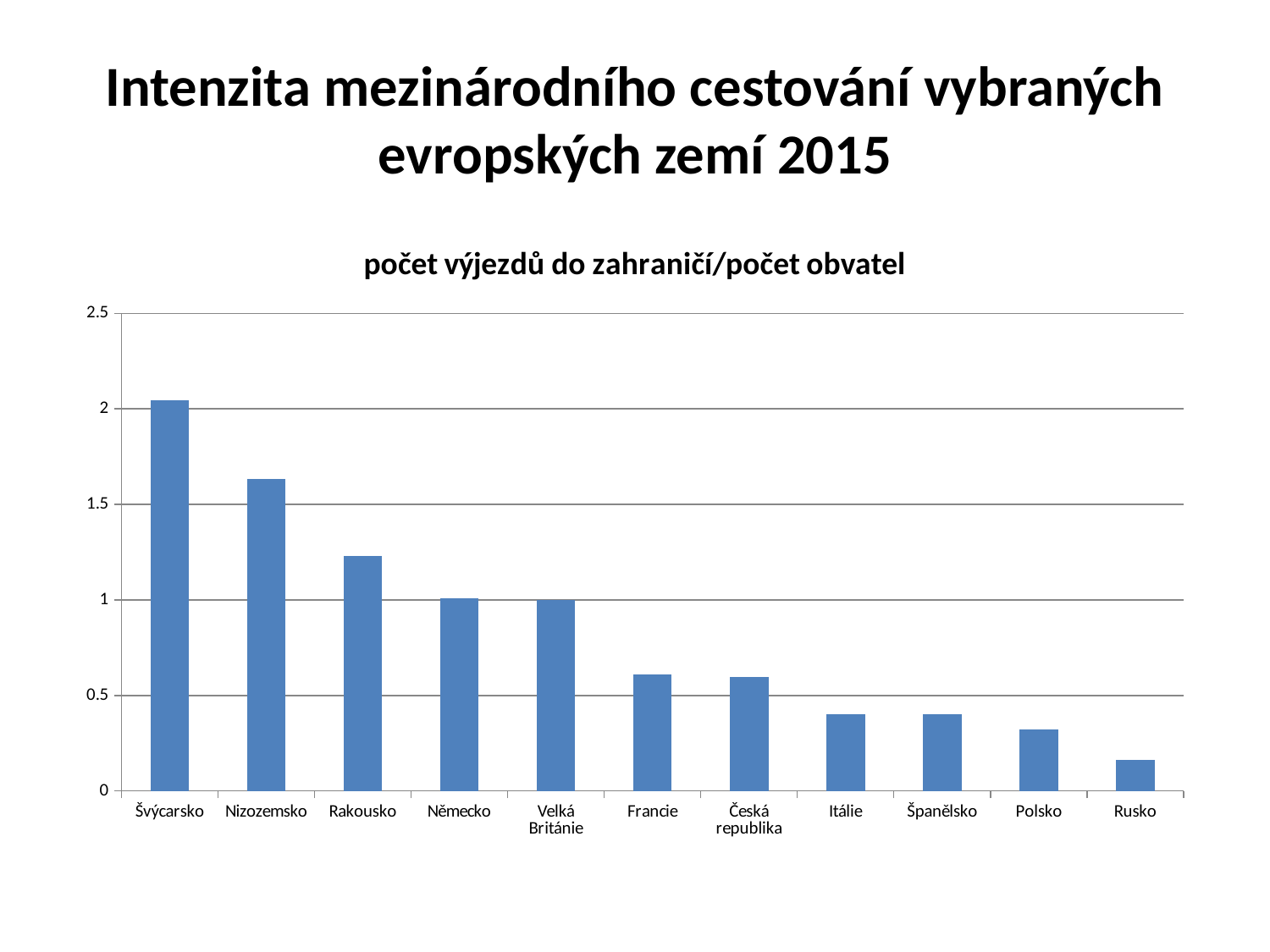
Is the value for Francie greater or less than 0.5? greater Do the values rise or fall moving from left to right along the x axis? fall What is the title printed above the chart? počet výjezdů do zahraničí/počet obvatel Is the value for Nizozemsko greater or less than 1.5? greater How many countries are shown on the x axis of the chart? 11 What kind of chart is shown on the slide? bar chart Which has the larger value, Polsko or Rusko? Polsko Which country has the lowest value in the chart? Rusko Which country has the highest value in the chart? Švýcarsko Is the value for Rakousko greater or less than 1? greater Which has the larger value, Nizozemsko or Rakousko? Nizozemsko